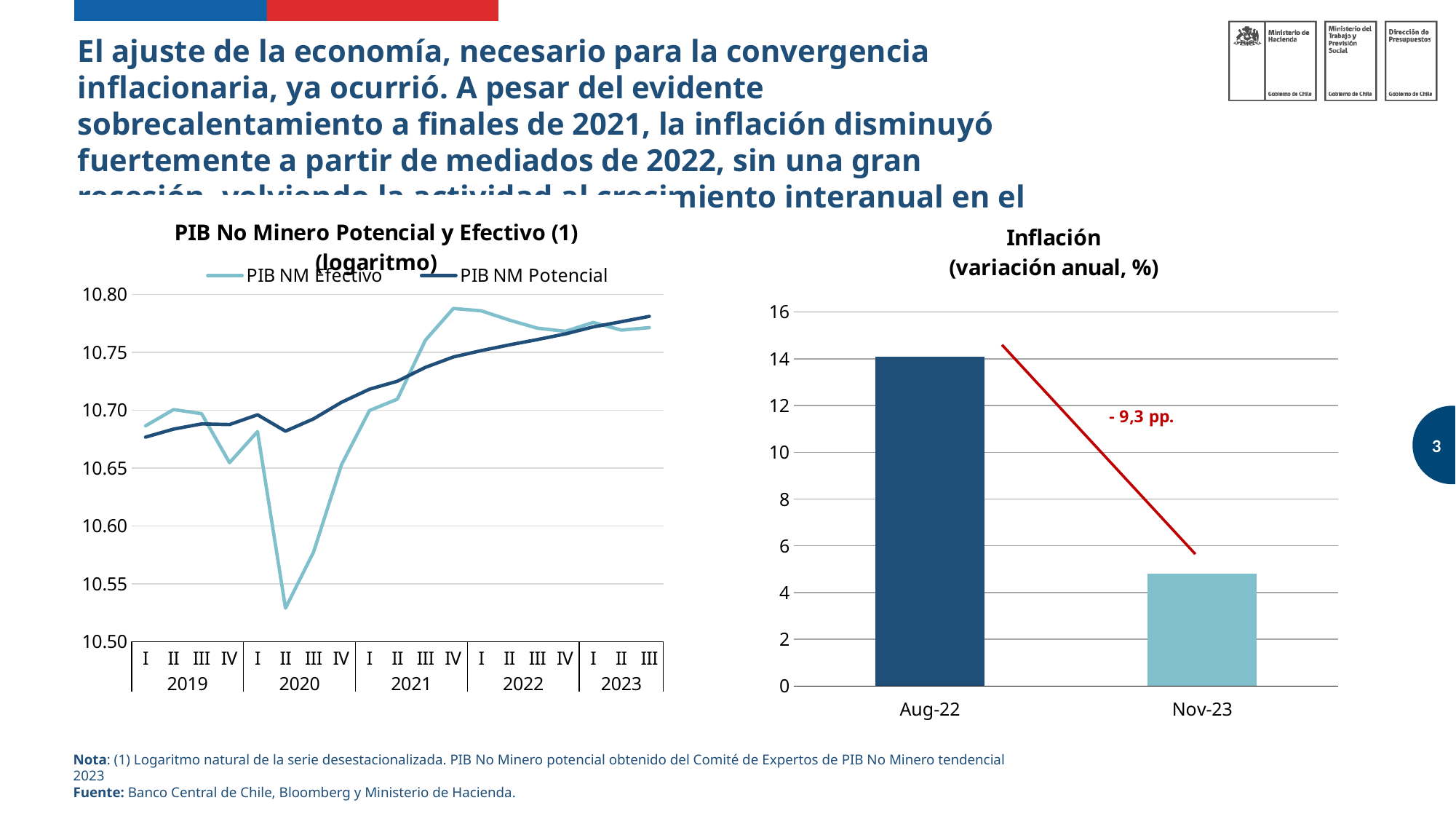
In the 'Inflación' chart, what change in percentage points is annotated between the two bars? - 9,3 pp. What kind of chart is the 'PIB No Minero Potencial y Efectivo (1)' chart on the left? line chart In the 'Inflación' chart, how many bars are plotted? 2 In the 'Inflación' chart, which period has the higher value, Aug-22 or Nov-23? Aug-22 In the 'PIB No Minero Potencial y Efectivo (1)' chart, is the PIB NM Efectivo value in 2020 II greater or less than 10.60? less What are the two series named in the legend of the 'PIB No Minero Potencial y Efectivo (1)' chart? PIB NM Efectivo and PIB NM Potencial How many series does the legend of the 'PIB No Minero Potencial y Efectivo (1)' chart list? 2 In the 'Inflación' chart, is the value for Nov-23 greater or less than 6? less In the 'PIB No Minero Potencial y Efectivo (1)' chart, does the PIB NM Potencial series generally rise or fall from 2019 to 2023? rise What kind of chart is the 'Inflación (variación anual, %)' chart on the right? bar chart In the 'Inflación' chart, is the value for Aug-22 greater or less than 12? greater In the 'PIB No Minero Potencial y Efectivo (1)' chart, in which quarter does the PIB NM Efectivo series reach its lowest point? 2020 II